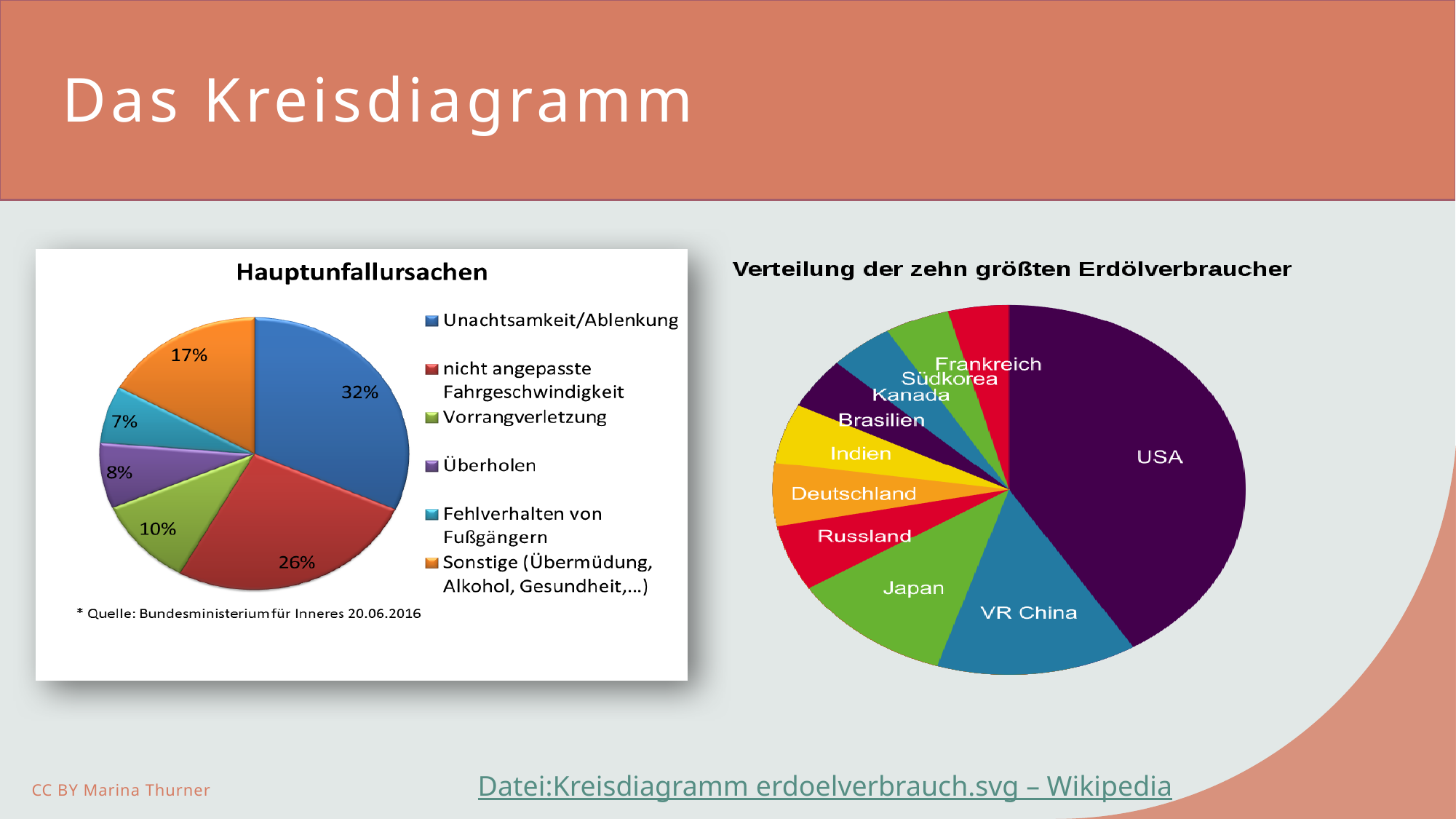
In the chart titled 'Hauptunfallursachen', what percentage is shown for nicht angepasste Fahrgeschwindigkeit? 26% In the chart titled 'Verteilung der zehn größten Erdölverbraucher', which slice is larger: VR China or Japan? VR China In the chart titled 'Hauptunfallursachen', what percentage is shown for Unachtsamkeit/Ablenkung? 32% How many countries are shown in the chart titled 'Verteilung der zehn größten Erdölverbraucher'? 10 In the chart titled 'Hauptunfallursachen', which category has the smallest share? Fehlverhalten von Fußgängern In the chart titled 'Hauptunfallursachen', which is larger: Vorrangverletzung or Überholen? Vorrangverletzung In the chart titled 'Hauptunfallursachen', which category has the largest share? Unachtsamkeit/Ablenkung What kind of chart is the chart titled 'Hauptunfallursachen'? Pie chart In the chart titled 'Verteilung der zehn größten Erdölverbraucher', which country has the largest slice? USA How many categories does the chart titled 'Hauptunfallursachen' show? 6 In the chart titled 'Hauptunfallursachen', what is the difference in percentage points between Unachtsamkeit/Ablenkung and nicht angepasste Fahrgeschwindigkeit? 6 In the chart titled 'Hauptunfallursachen', what percentage is shown for Sonstige (Übermüdung, Alkohol, Gesundheit,...)? 17%